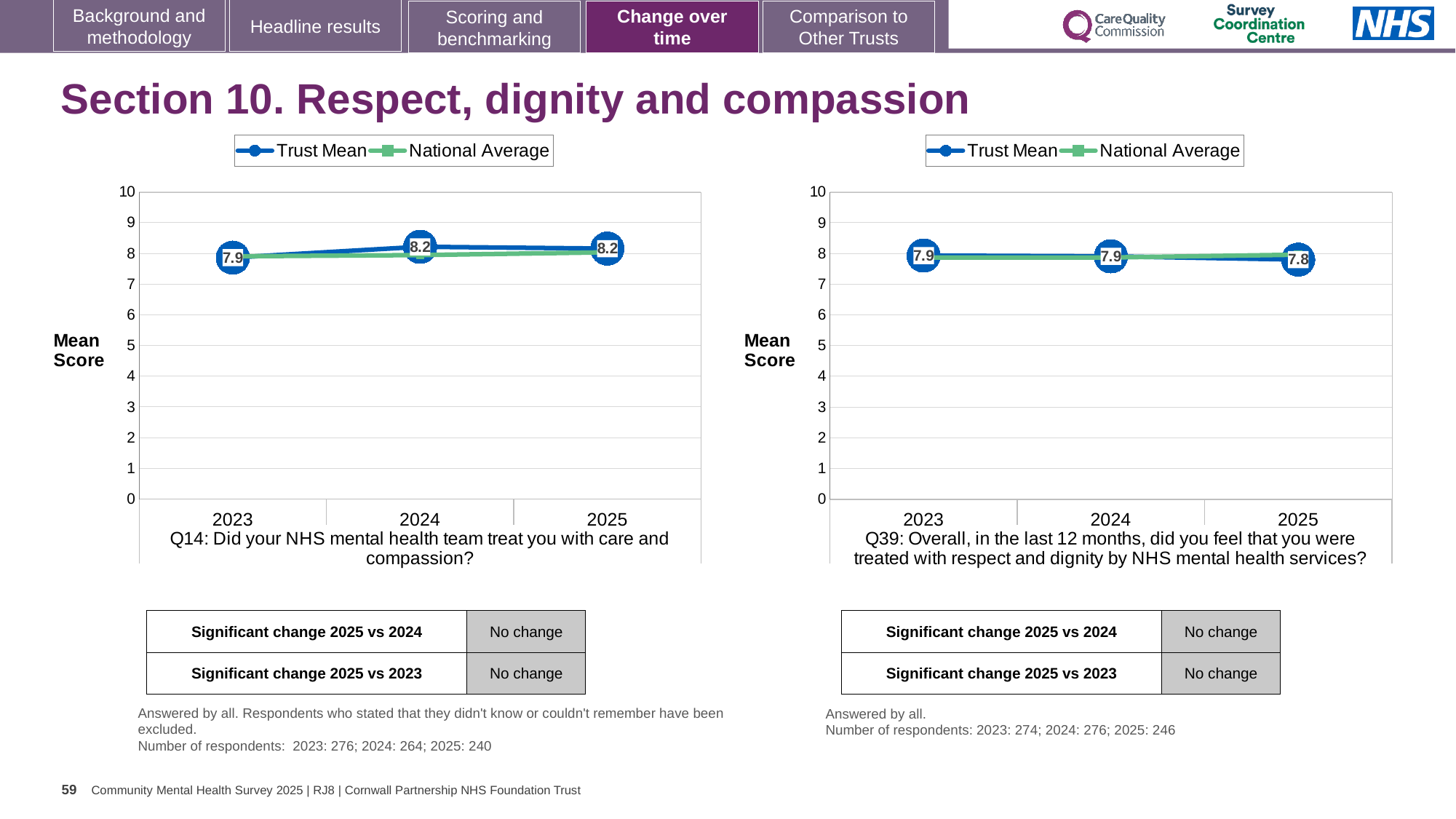
On the left chart (Q14), what is the difference between the Trust Mean in 2025 and in 2023? 0.3 On the left chart (Q14), what is the Trust Mean for 2023? 7.9 On the right chart (Q39), is the Trust Mean for 2023 larger or smaller than the Trust Mean for 2025? larger On the right chart (Q39), is the National Average for 2024 greater or less than 9? less On the left chart (Q14), what is the Trust Mean for 2025? 8.2 On the right chart (Q39), what is the Trust Mean for 2025? 7.8 On the left chart (Q14), which year has the lowest Trust Mean? 2023 On the left chart (Q14), does the Trust Mean rise or fall from 2023 to 2024? rise On the right chart (Q39), what is the Trust Mean for 2024? 7.9 How many series does the legend of the right chart (Q39) list? 2 How many years are shown on the x axis of the left chart (Q14)? 3 What kind of chart is the left chart (Q14)? line chart